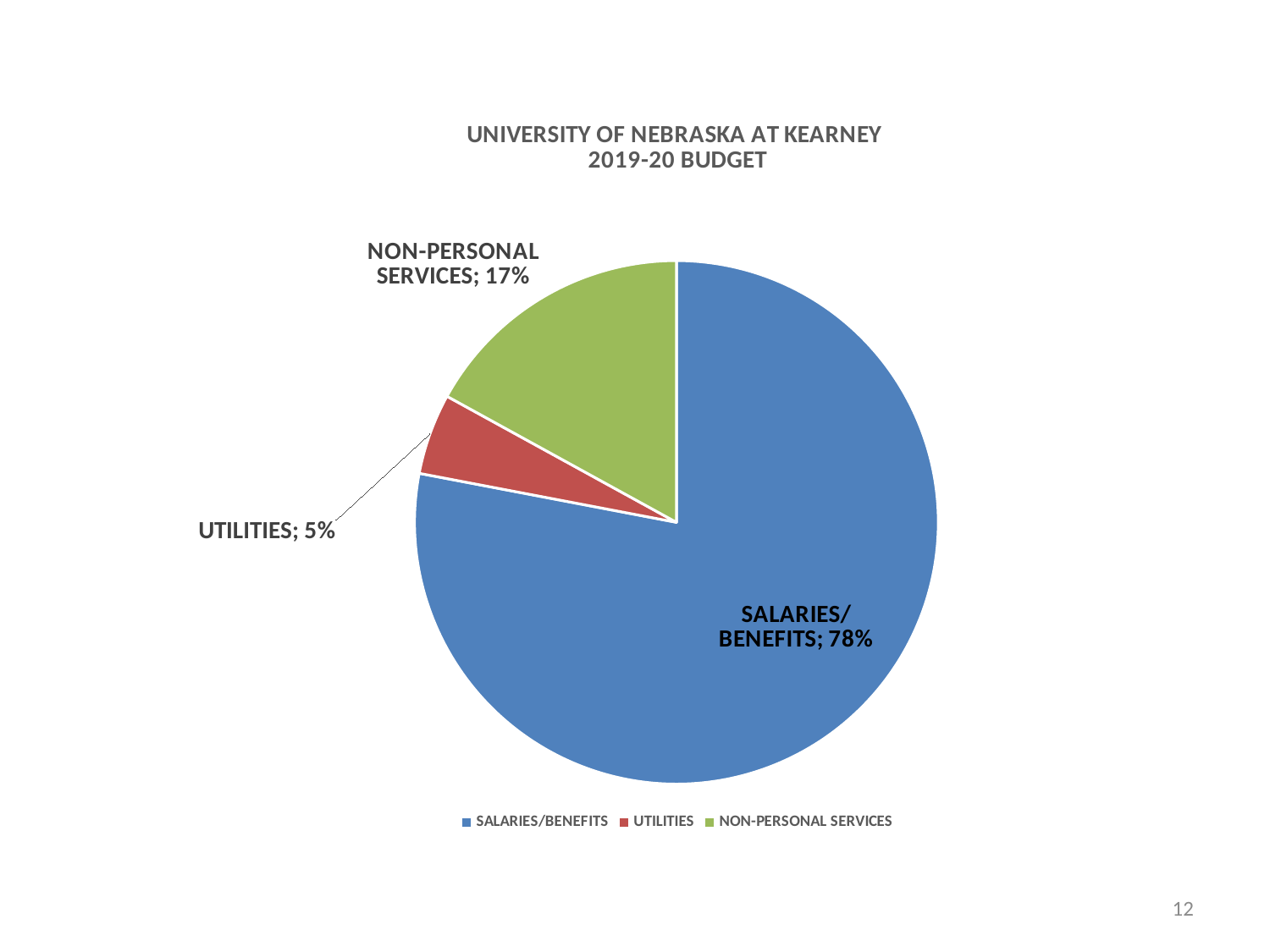
What is the title of the chart? UNIVERSITY OF NEBRASKA AT KEARNEY 2019-20 BUDGET How many entries does the legend list? 3 What is the difference in percentage points between SALARIES/BENEFITS and NON-PERSONAL SERVICES? 61 percentage points What colour is the UTILITIES slice? Red Which is larger, the share for UTILITIES or the share for NON-PERSONAL SERVICES? NON-PERSONAL SERVICES Which category has the smallest share of the budget? UTILITIES What share of the budget is NON-PERSONAL SERVICES? 17% Which category has the largest share of the budget? SALARIES/BENEFITS What share of the budget is SALARIES/BENEFITS? 78% What type of chart is shown on the slide? Pie chart How many categories are shown in the pie chart? 3 What share of the budget is UTILITIES? 5%